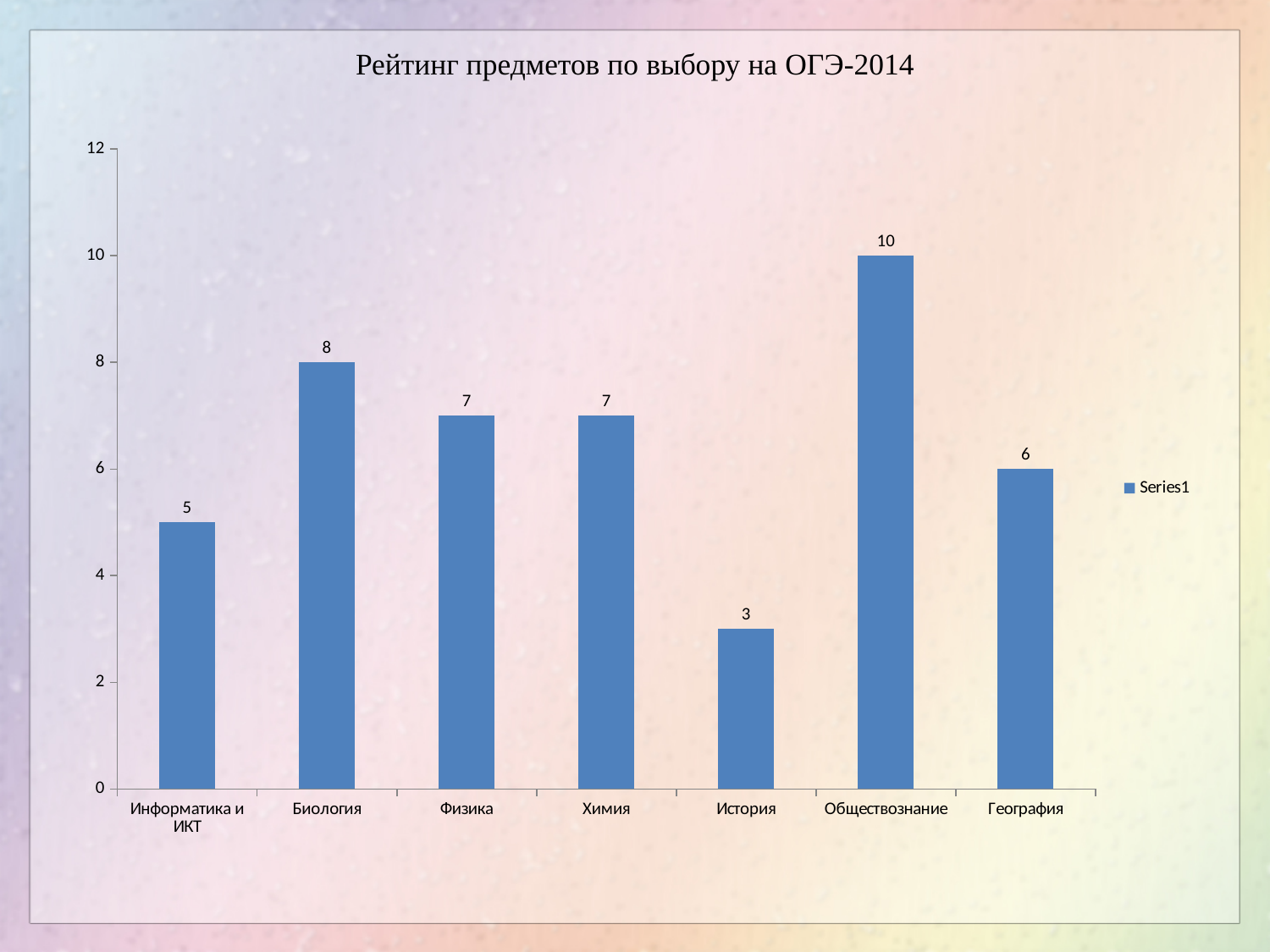
Which is larger, the value for Физика or the value for География? Физика What is the difference between the values for Биология and География? 2 What is the difference between the values for Обществознание and История? 7 What kind of chart is shown on the slide? Bar chart What is the value for Информатика и ИКТ? 5 What is the title of the chart? Рейтинг предметов по выбору на ОГЭ-2014 What is the value for История? 3 Which subject has the highest value? Обществознание What is the value for Обществознание? 10 What is the value for Биология? 8 How many subjects are shown on the x axis? 7 Which subject has the lowest value? История